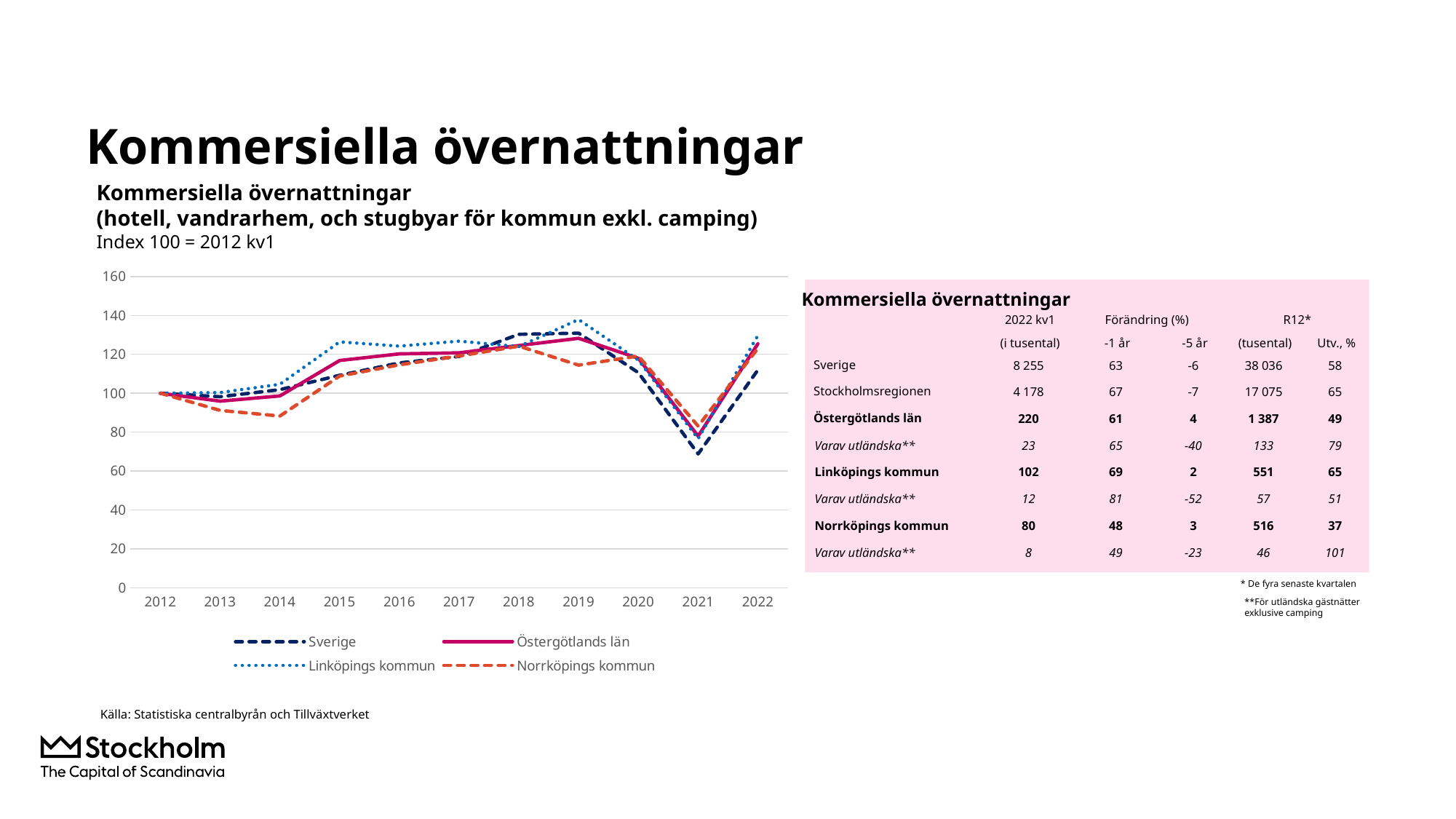
Is the value for Sverige in 2021 greater or less than 80? less How many series does the chart legend list? 4 How many years are shown on the x axis of the chart? 11 What is the index base stated under the chart title? Index 100 = 2012 kv1 What kind of chart is shown on the slide? line chart In which year is the Sverige line at its lowest? 2021 In which year does the Linköpings kommun line reach its highest value? 2019 In 2014, which is higher: Linköpings kommun or Norrköpings kommun? Linköpings kommun What is the index value for Sverige in 2012? 100 Is the value for Linköpings kommun in 2019 greater or less than 120? greater Does the Sverige line rise or fall from 2019 to 2021? fall Is the value for Norrköpings kommun in 2014 greater or less than 100? less